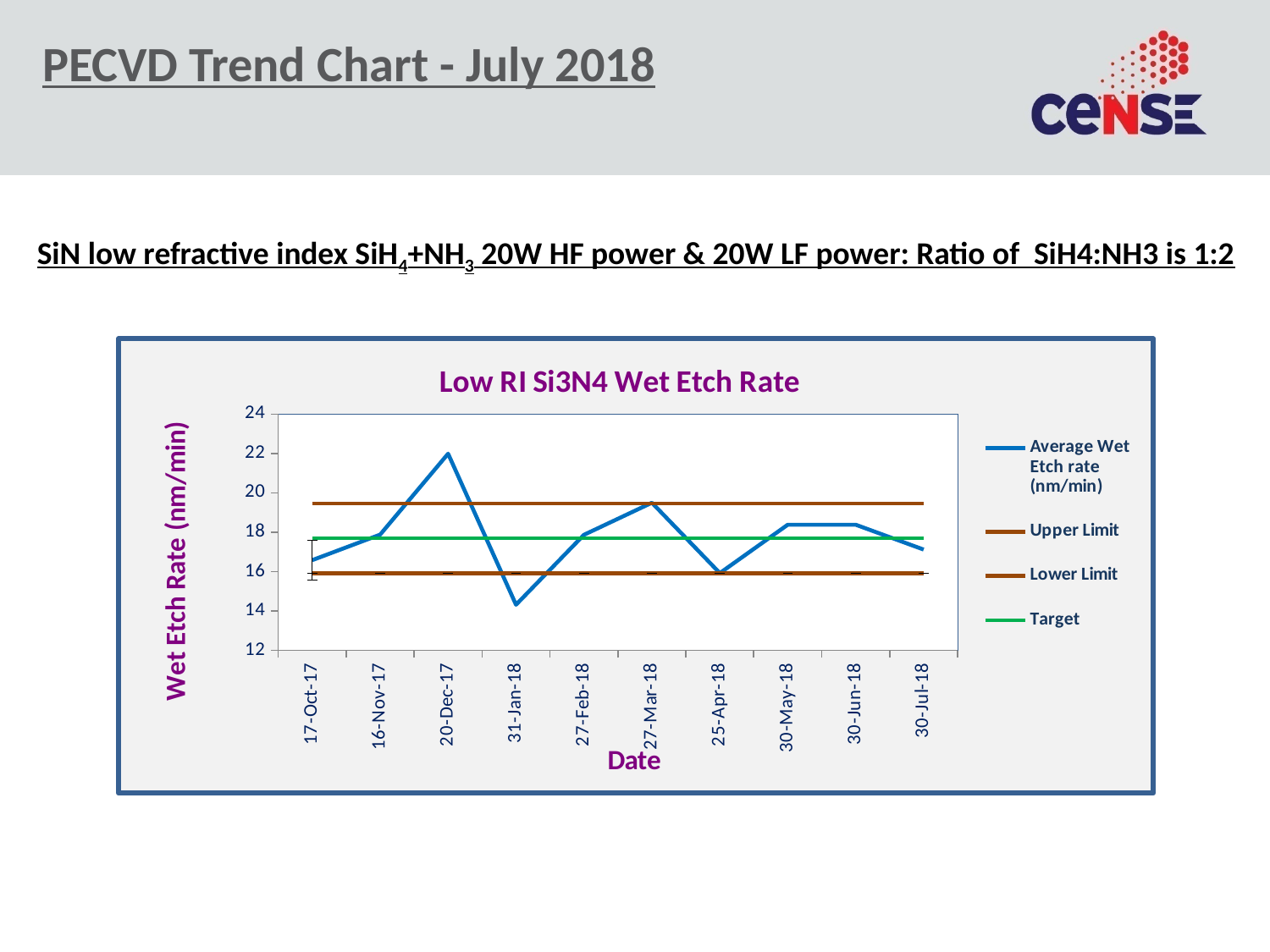
Is the Average Wet Etch rate for 17-Oct-17 greater or less than 18? less Which has the larger Average Wet Etch rate, 20-Dec-17 or 31-Jan-18? 20-Dec-17 Which has the larger Average Wet Etch rate, 27-Mar-18 or 25-Apr-18? 27-Mar-18 On which date is the Average Wet Etch rate lowest? 31-Jan-18 How many series does the chart legend list? 4 What kind of chart is shown on the slide? line chart On which date is the Average Wet Etch rate highest? 20-Dec-17 What is the label of the y axis of the chart? Wet Etch Rate (nm/min) What is the title of the chart? Low RI Si3N4 Wet Etch Rate Is the Average Wet Etch rate for 31-Jan-18 greater or less than 16? less How many dates are shown on the x axis of the chart? 10 Is the Average Wet Etch rate for 20-Dec-17 greater or less than 20? greater